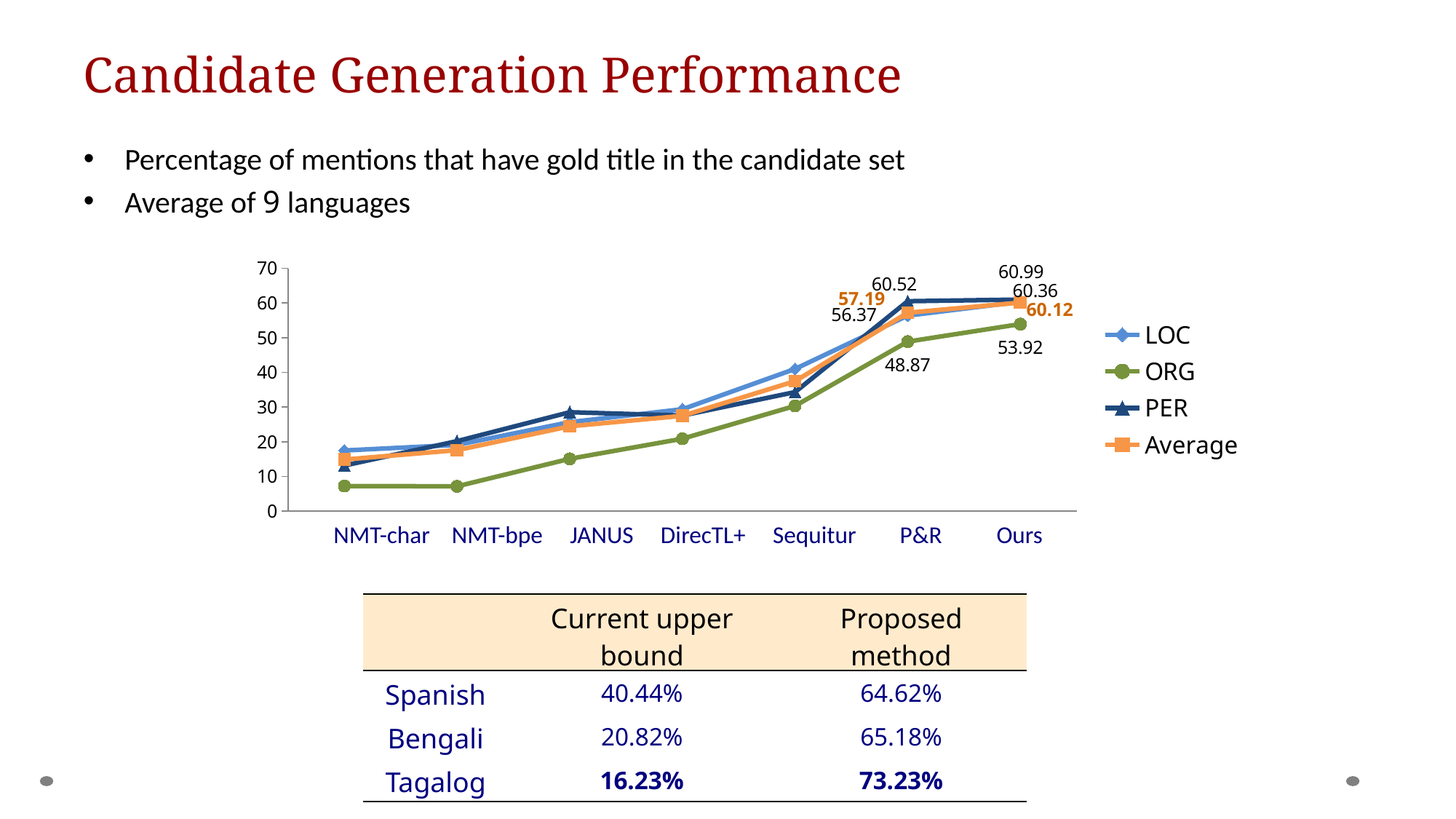
Does the Average series generally rise or fall from NMT-char to Ours? rise How many series does the chart legend list? 4 Is the ORG value for P&R larger or smaller than the PER value for P&R? smaller How many methods are shown along the x axis of the chart? 7 What is the PER value for the P&R method? 60.52 Is the ORG value for NMT-char greater or less than 10? less What is the ORG value for the Ours method? 53.92 Which series has the lowest value for the Ours method? ORG What is the difference between the Average value for Ours and the Average value for P&R? 2.93 What is the LOC value for the P&R method? 56.37 What type of chart is shown on the slide? line chart What is the Average value for the Ours method? 60.12